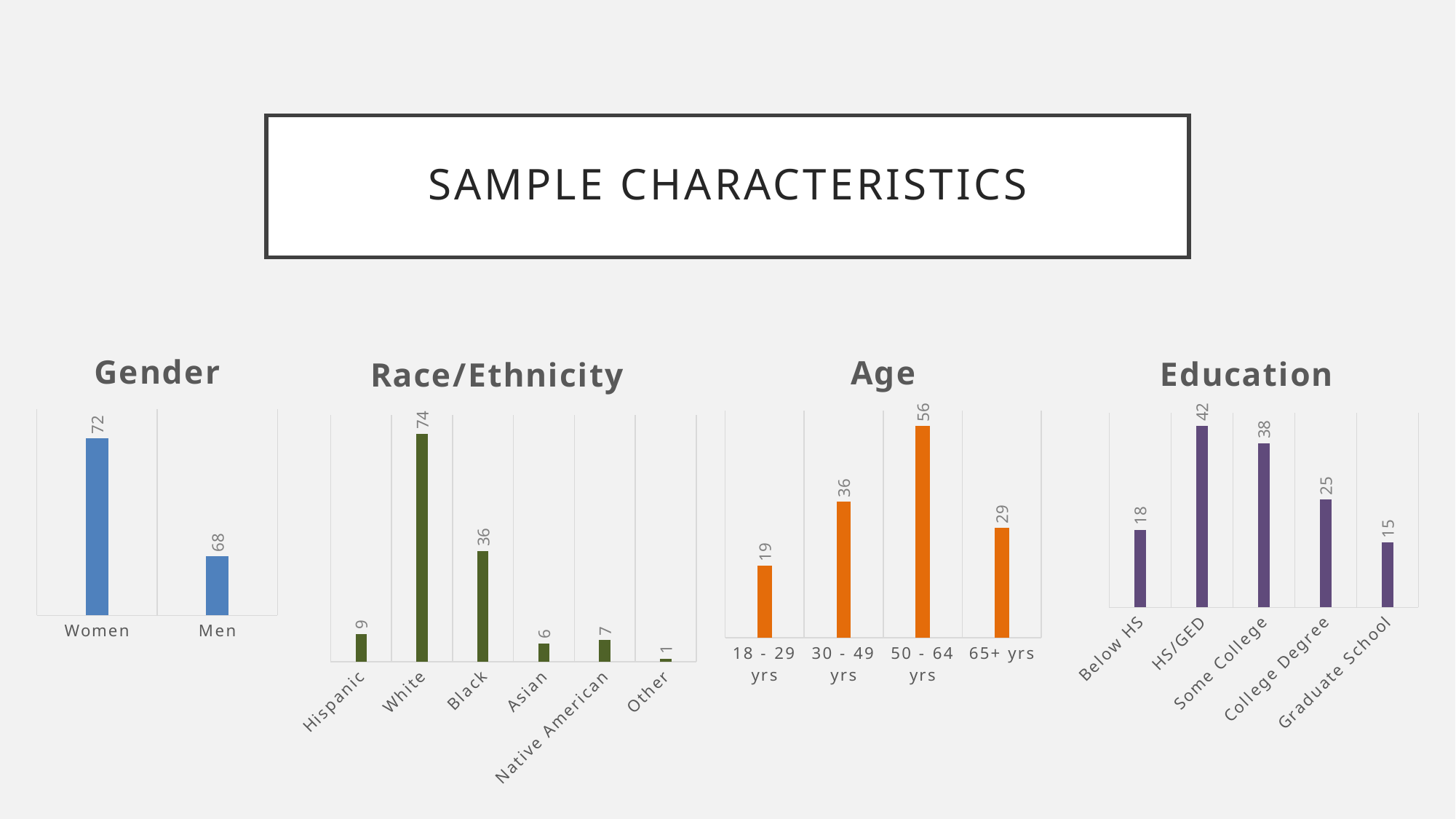
In the Gender chart, what is the difference between the values for Women and Men? 4 In the Education chart, which is larger, the value for HS/GED or the value for Some College? HS/GED In the Age chart, what is the value for 18 - 29 yrs? 19 In the Race/Ethnicity chart, which category has the highest value? White In the Race/Ethnicity chart, what is the value for Black? 36 In the Age chart, which age group has the highest value? 50 - 64 yrs What type of chart is the Education chart? Bar chart In the Education chart, which category has the lowest value? Graduate School In the Gender chart, what is the value for Women? 72 In the Race/Ethnicity chart, which category has the lowest value? Other In the Age chart, what is the difference between the values for 50 - 64 yrs and 30 - 49 yrs? 20 How many categories are shown in the Race/Ethnicity chart? 6